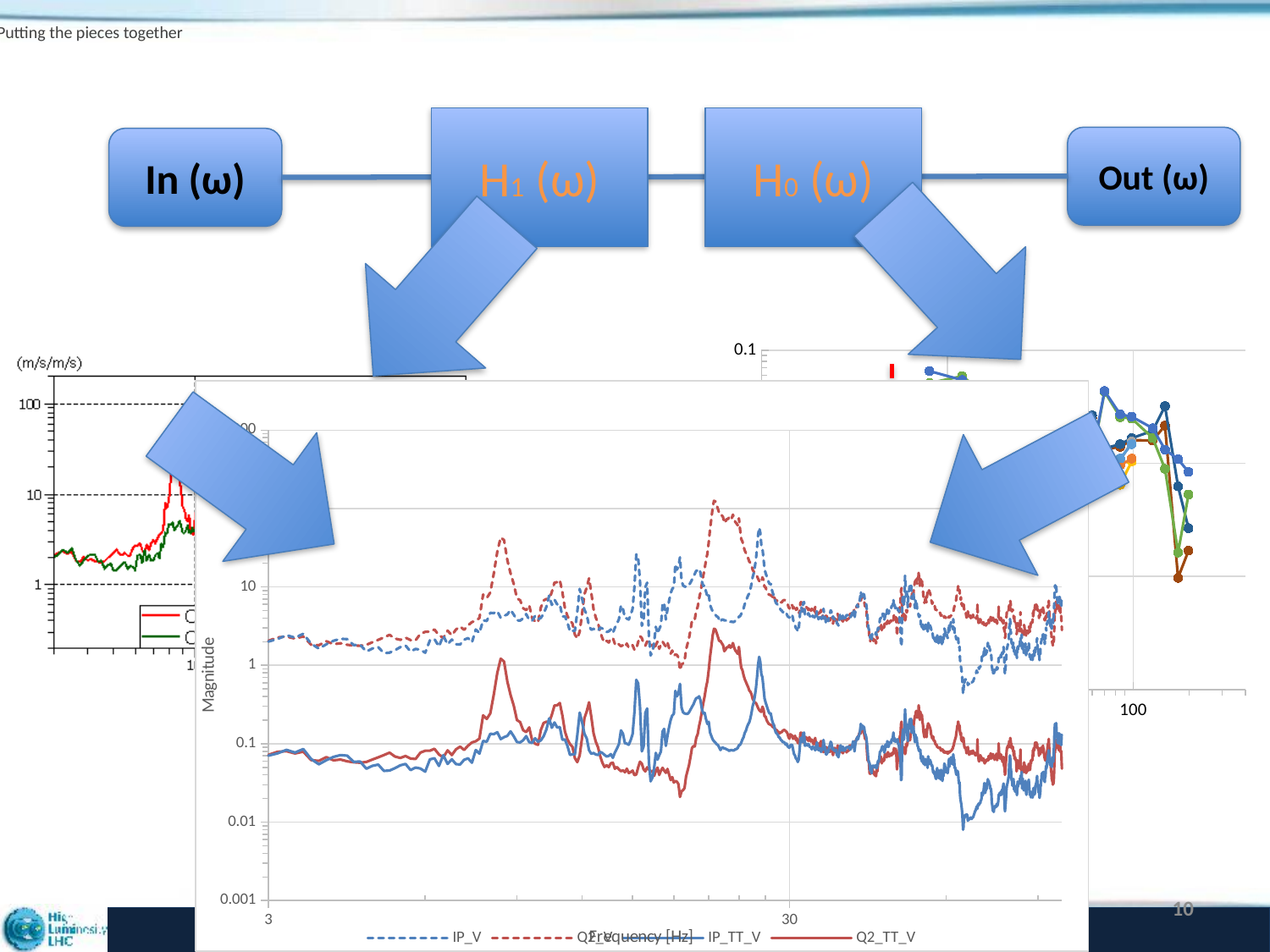
How many series does the legend of the central Magnitude vs Frequency chart list? 4 In the central chart, is the value of IP_V at 3 Hz greater or less than 1? greater What is the lowest tick value shown on the y-axis of the central chart? 0.001 What is the y-axis label of the central chart? Magnitude In the central chart, is the highest peak of Q2_TT_V greater or less than 1? greater In the central chart, which series is higher at 3 Hz, IP_V or IP_TT_V? IP_V What kind of chart is the large central chart with the legend IP_V, Q2_V, IP_TT_V, Q2_TT_V? line chart In the central chart, is the lowest point of IP_TT_V greater or less than 0.1? less In the central chart, which series is higher at 3 Hz, Q2_V or Q2_TT_V? Q2_V What is the x-axis label of the central chart? Frequency [Hz]